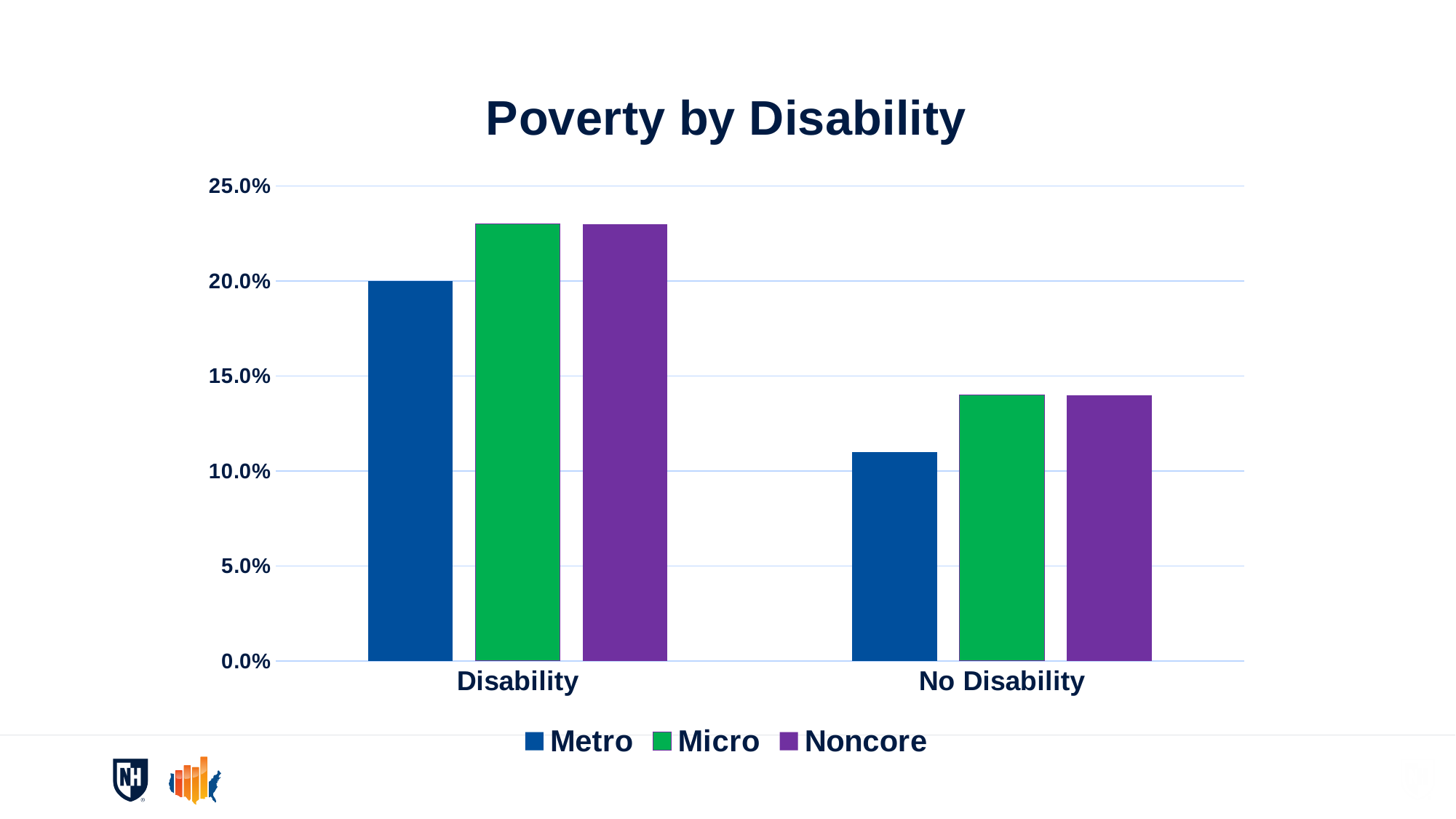
How many series does the legend list? 3 Is the Noncore value for No Disability greater or less than 15.0%? less What type of chart is shown on the slide? bar chart In the Disability category, which is larger, the Metro value or the Micro value? Micro Which series has the lowest value in the No Disability category? Metro Is the Metro value for No Disability greater or less than 10.0%? greater How many categories are shown on the x axis? 2 Which colour represents the Noncore series in the legend? purple What is the Metro value for the Disability category? 20.0% For the Metro series, which category has the larger value, Disability or No Disability? Disability What is the title of the chart? Poverty by Disability Is the Micro value for Disability greater or less than 20.0%? greater